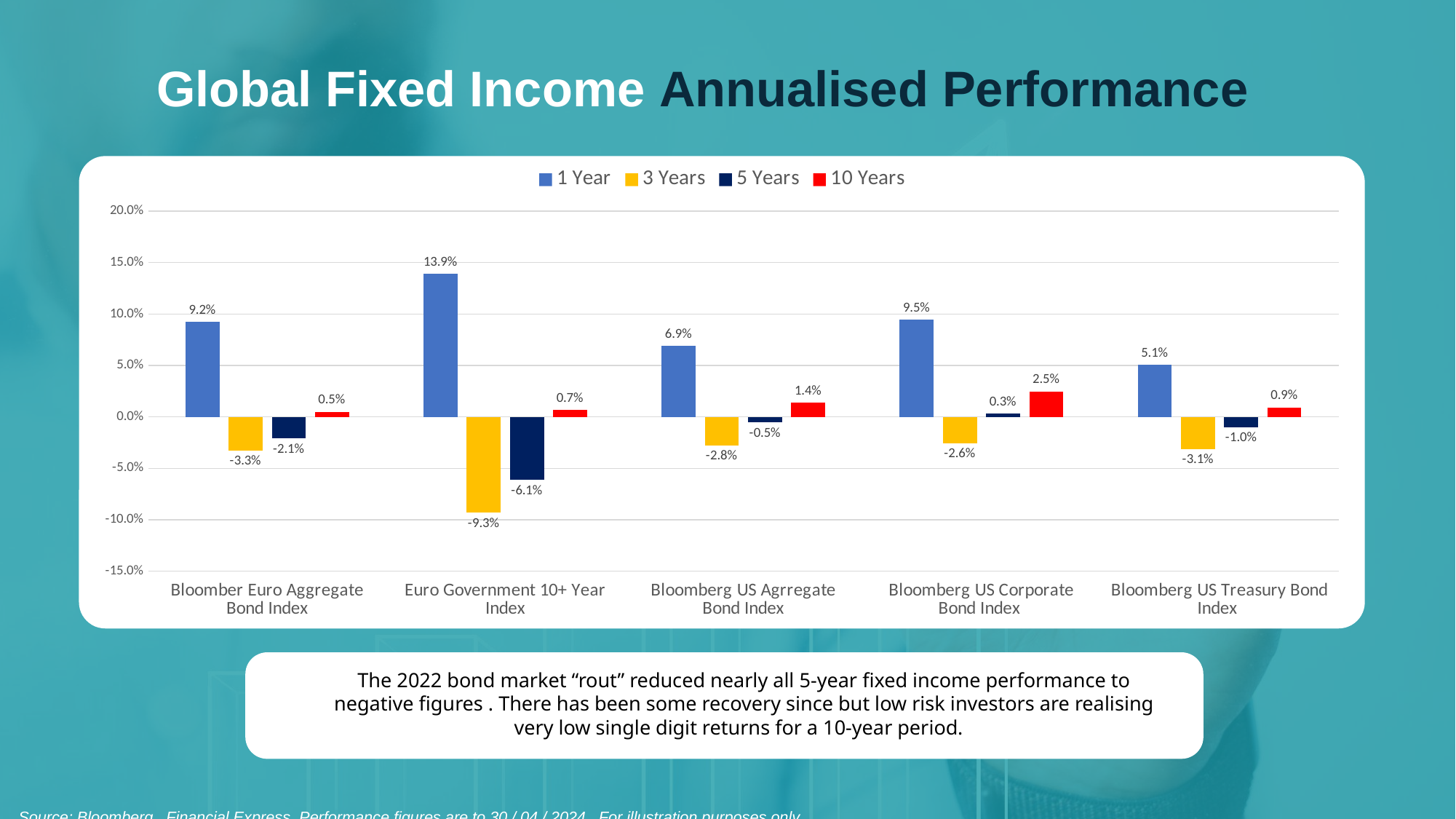
What is the 10 Years value for the Bloomberg US Corporate Bond Index? 2.5% Which colour represents the 10 Years series in the legend? Red What is the 1 Year value for the Euro Government 10+ Year Index? 13.9% What is the 5 Years value for the Bloomberg US Agrregate Bond Index? -0.5% What is the difference between the 1 Year values for the Bloomberg US Corporate Bond Index and the Bloomberg US Treasury Bond Index? 4.4% What kind of chart is shown on the slide? Bar chart What is the 3 Years value for the Bloomberg US Treasury Bond Index? -3.1% Which index has the highest 1 Year value? Euro Government 10+ Year Index How many indices are shown on the x axis? 5 How many series does the legend list? 4 Which is larger: the 10 Years value for the Bloomber Euro Aggregate Bond Index or the 10 Years value for the Bloomberg US Treasury Bond Index? Bloomberg US Treasury Bond Index Which index has the lowest 3 Years value? Euro Government 10+ Year Index